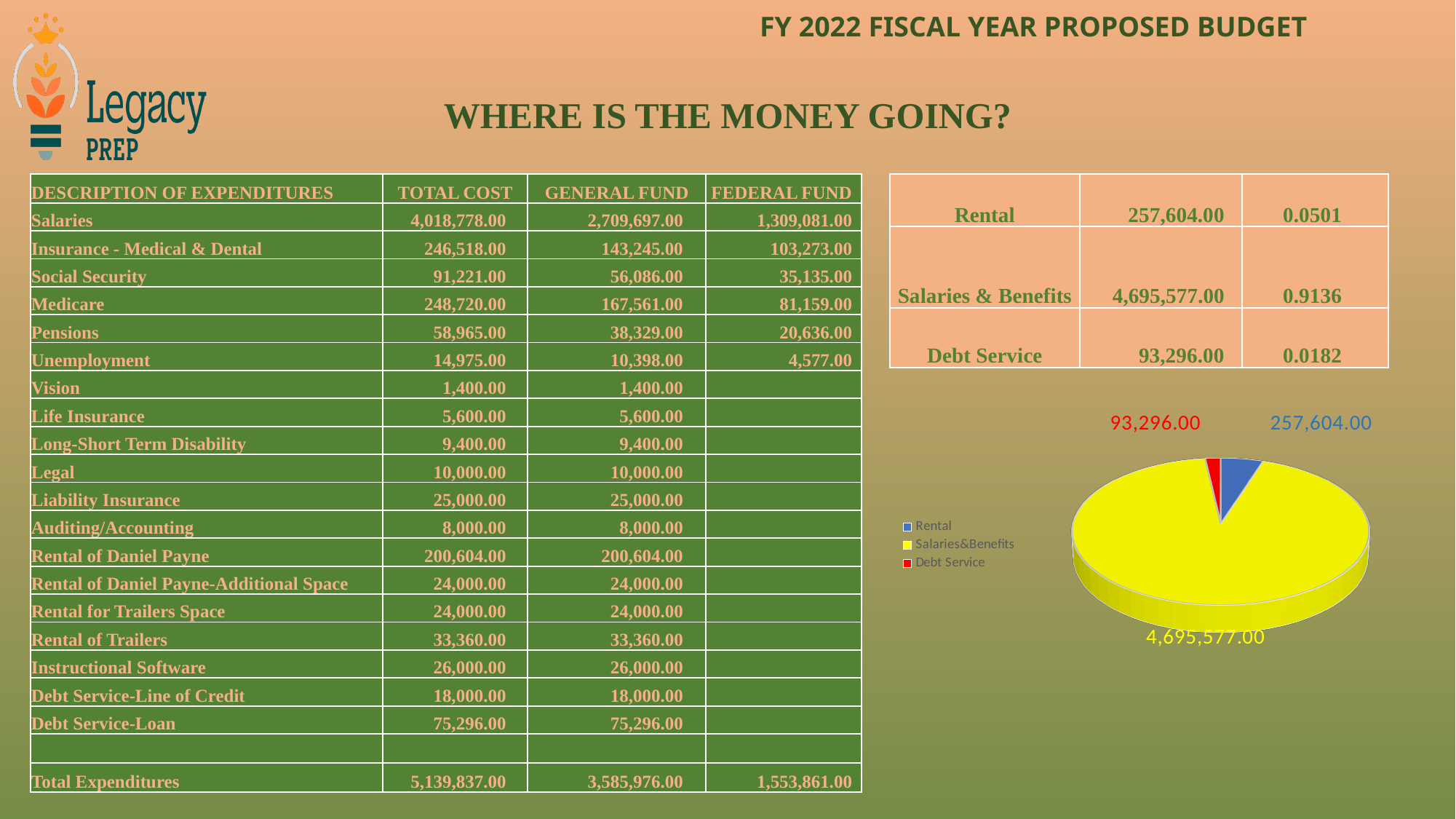
How many entries does the pie chart's legend list? 3 What is the difference between the Rental value and the Debt Service value in the pie chart? 164,308.00 What value is labelled on the Debt Service slice of the pie chart? 93,296.00 What value is labelled on the Salaries&Benefits slice of the pie chart? 4,695,577.00 Which slice of the pie chart is the largest? Salaries&Benefits What colour is the Salaries&Benefits slice in the pie chart? yellow What kind of chart is shown on the slide? pie chart Which slice of the pie chart is the smallest? Debt Service What colour is the Debt Service slice in the pie chart? red How many slices does the pie chart have? 3 In the pie chart, which is larger: Rental or Debt Service? Rental What value is labelled on the Rental slice of the pie chart? 257,604.00